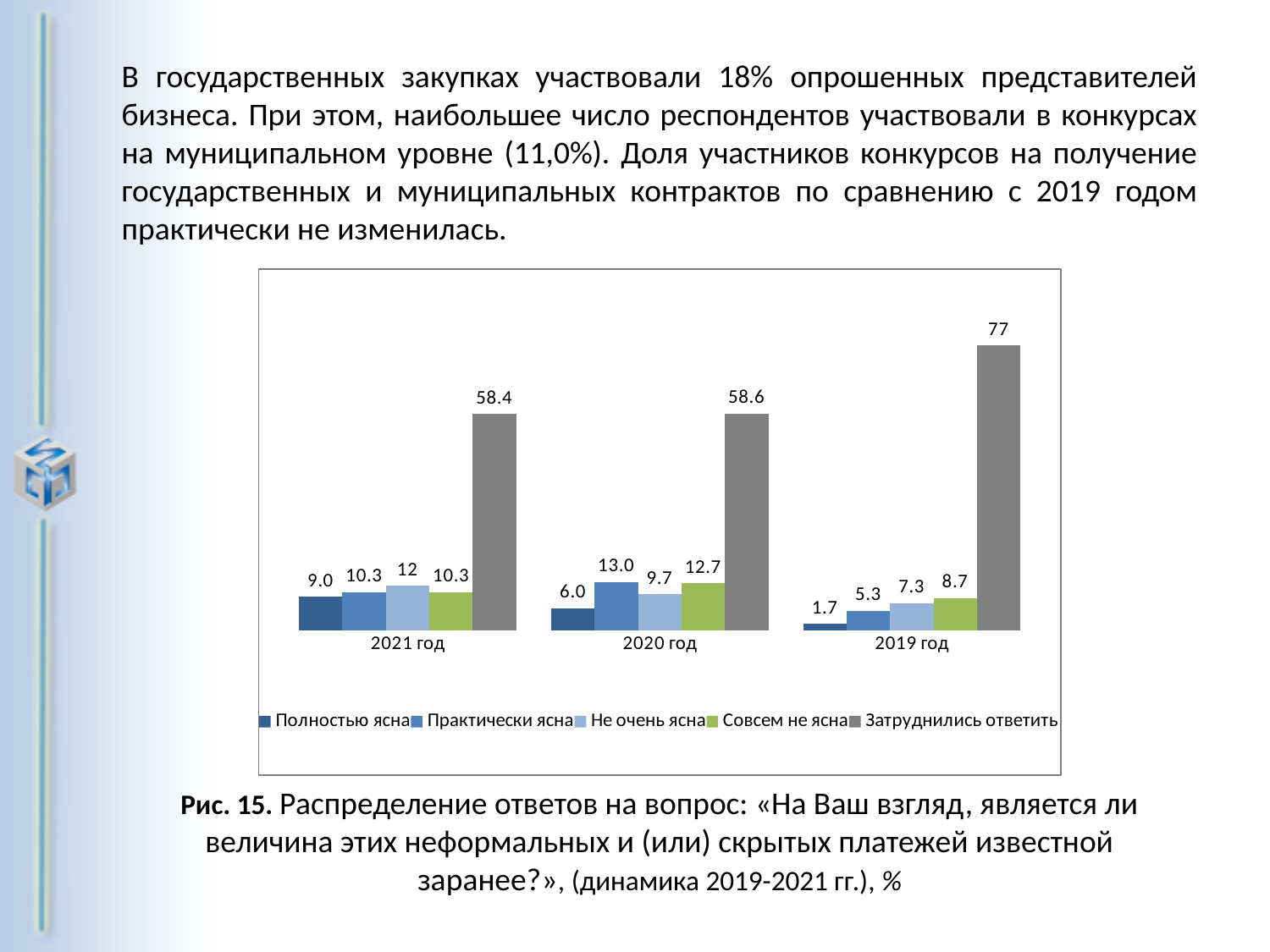
What is the value for «Совсем не ясна» in 2019 год? 8.7 What is the difference between the «Затруднились ответить» values for 2019 год and 2021 год? 18.6 In which year is the value for «Затруднились ответить» highest? 2019 год What type of chart is shown on the slide? bar chart What is the value for «Полностью ясна» in 2021 год? 9.0 What is the value for «Практически ясна» in 2020 год? 13.0 In which year is the value for «Полностью ясна» lowest? 2019 год What is the value for «Затруднились ответить» in 2019 год? 77 Which is larger: «Не очень ясна» in 2021 год or «Не очень ясна» in 2020 год? 2021 год Which series is shown in green in the legend? Совсем не ясна How many year categories are shown on the x axis? 3 How many series does the legend list? 5